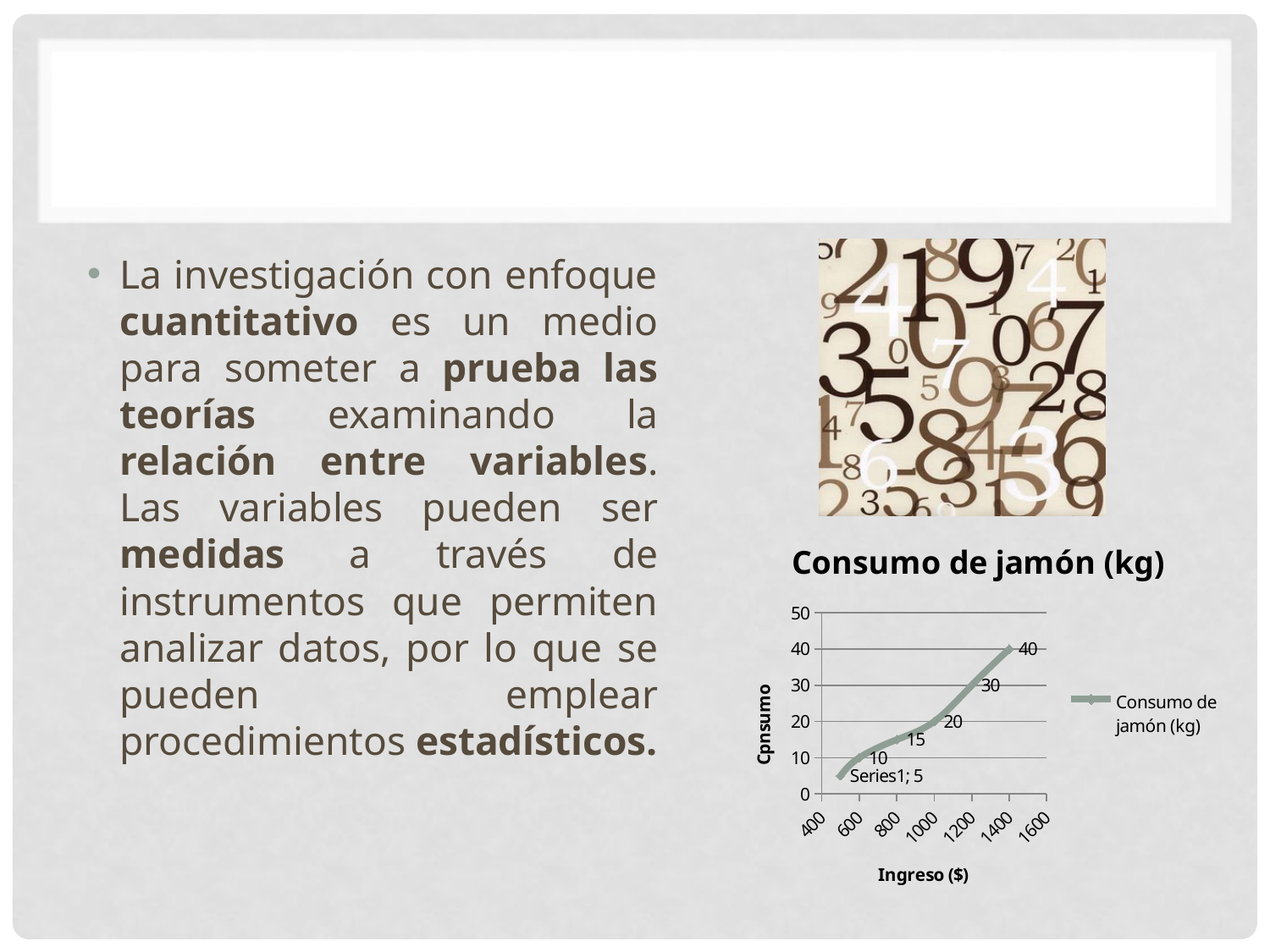
What is the difference between the highest and lowest plotted values? 35 What is the title of the chart? Consumo de jamón (kg) What is the label of the x axis of the chart? Ingreso ($) How many data points are plotted on the line? 6 What is the difference between the last two plotted values, 30 and 40? 10 What is the lowest value plotted on the line? 5 What is the highest value plotted on the line? 40 What kind of chart is shown on the slide? line chart Do the values rise or fall as income (Ingreso) increases along the x axis? rise Which is larger, the first plotted value or the last plotted value? the last plotted value Is the highest plotted value greater or less than 30? greater How many series does the chart legend list? 1